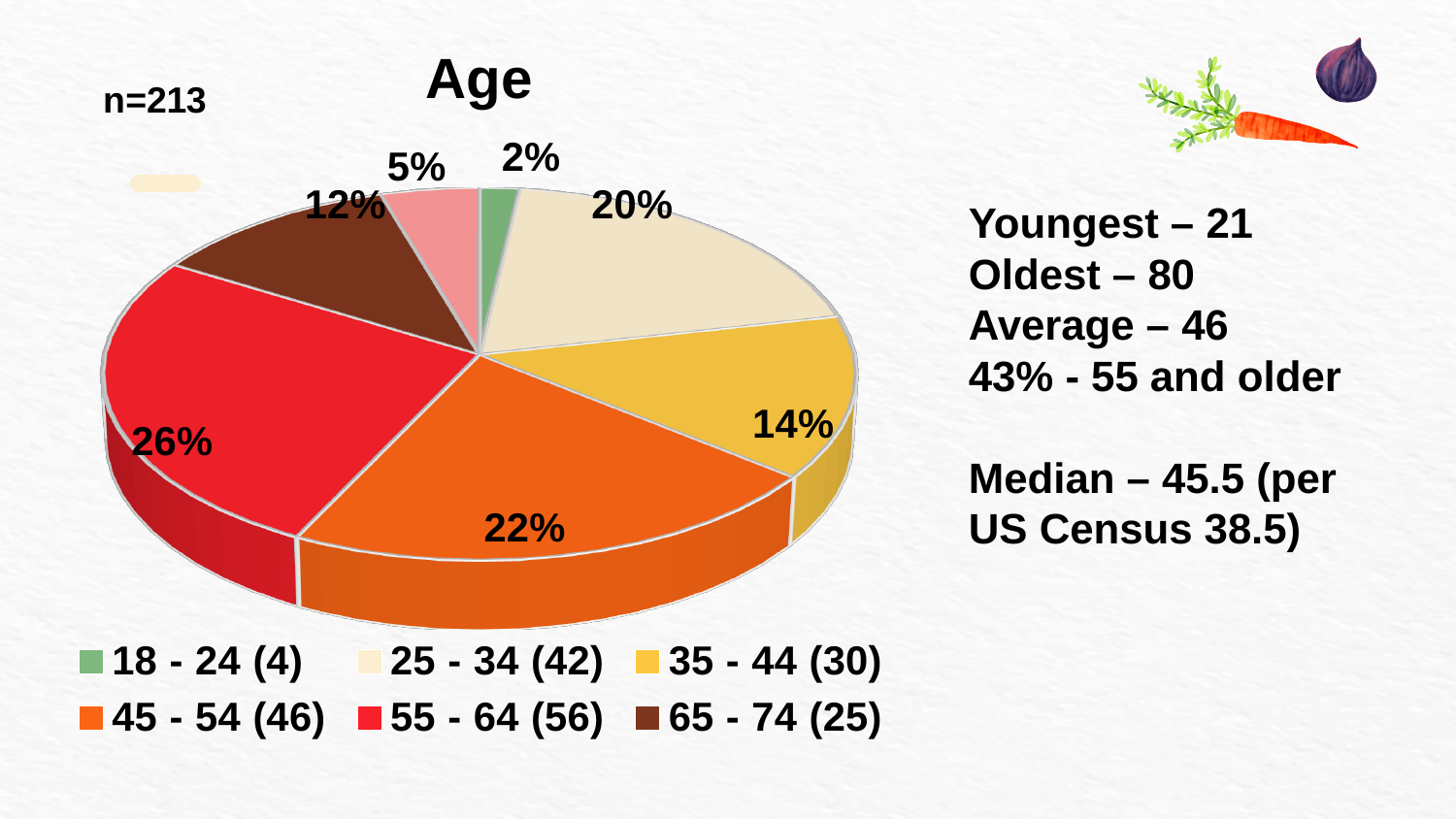
Which age group has the largest share of the pie? 55 - 64 Which age group has the smallest share of the pie? 18 - 24 How many age groups are listed in the legend? 6 What percentage of the pie does the 18 - 24 age group represent? 2% How many respondents are in the 45 - 54 age group according to the legend? 46 Which age group has a larger share: 45 - 54 or 65 - 74? 45 - 54 What percentage of the pie does the 35 - 44 age group represent? 14% What percentage of the pie does the 25 - 34 age group represent? 20% What is the title of the chart? Age What kind of chart is shown on the slide? pie chart What is the difference in percentage points between the 55 - 64 slice and the 35 - 44 slice? 12